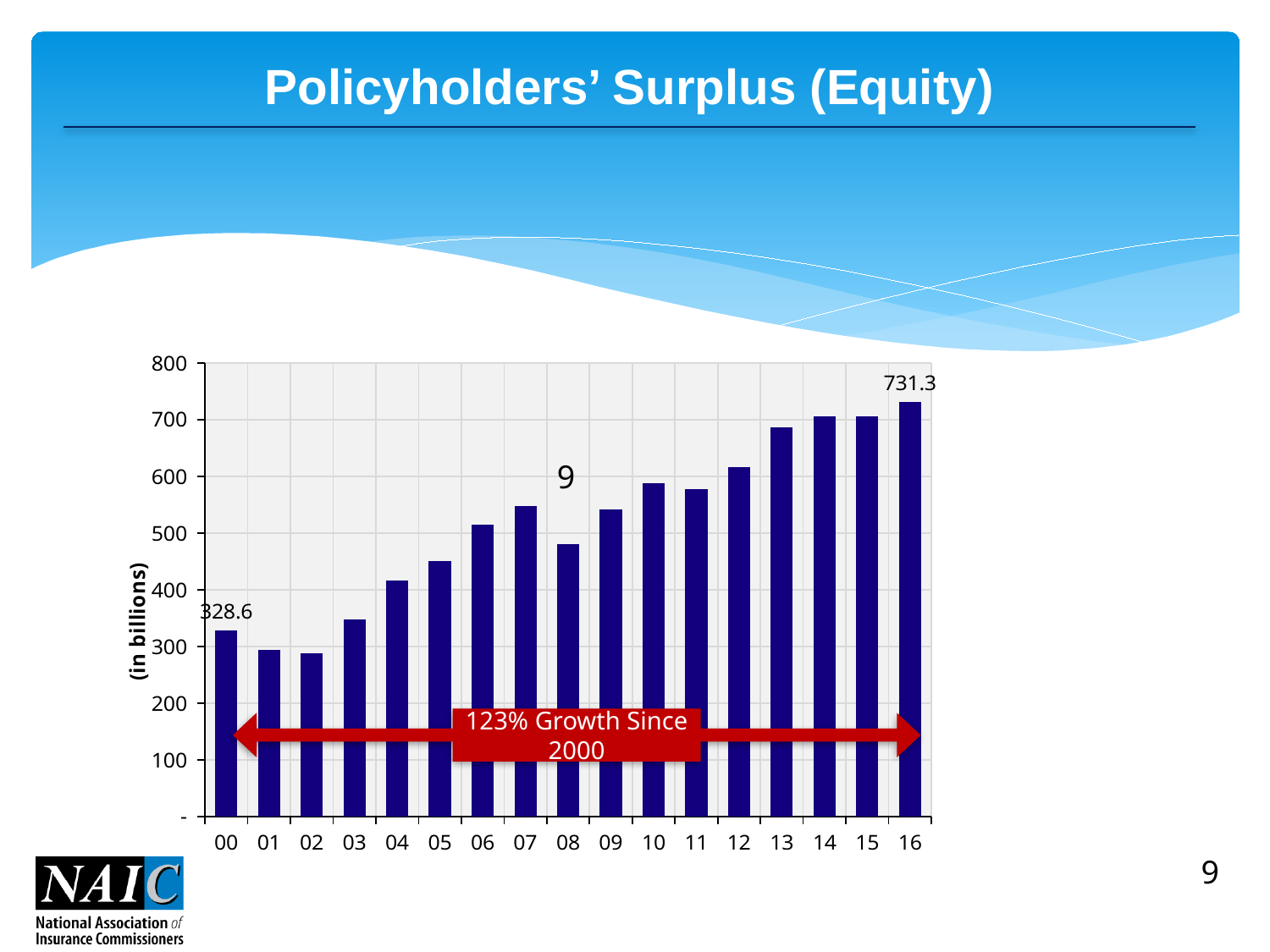
What is the value for 00 (year 2000)? 328.6 Do the values generally rise or fall from 00 to 16? rise Which year has the highest policyholders' surplus? 16 Is the value for 03 greater or less than 400? less How many years (bars) are shown in the chart? 17 What is the value for 16 (year 2016)? 731.3 What growth percentage since 2000 is stated on the red arrow in the chart? 123% Which is larger, the value for 07 or the value for 08? 07 Is the value for 08 greater or less than 500? less What kind of chart is shown on the slide? bar chart What is the difference between the value for 16 and the value for 00? 402.7 Is the value for 13 greater or less than 600? greater